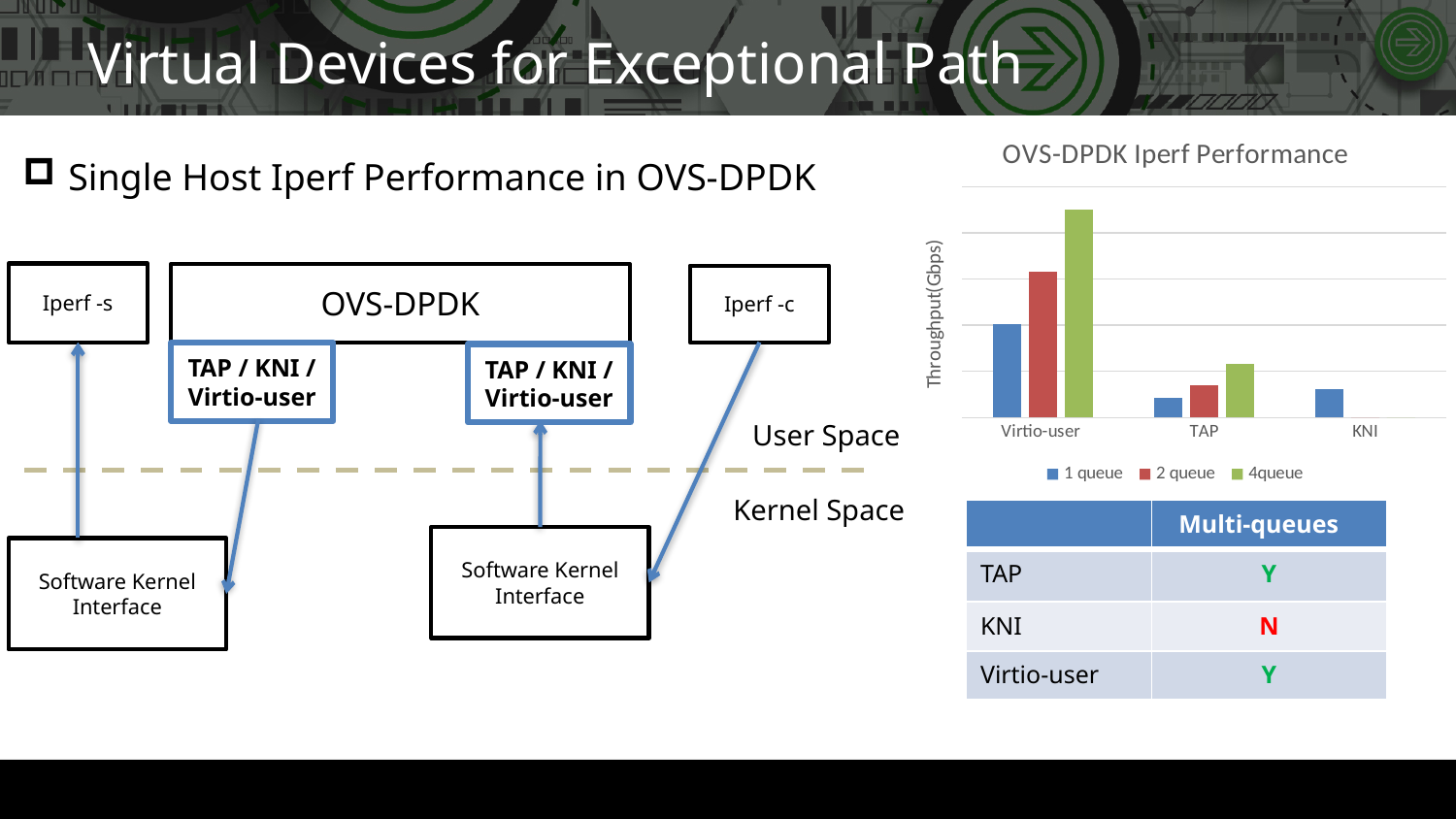
In the OVS-DPDK Iperf Performance chart, which series has the shortest bar for Virtio-user? 1 queue What is the y-axis label of the OVS-DPDK Iperf Performance chart? Throughput(Gbps) In the OVS-DPDK Iperf Performance chart, which category has the lowest 1 queue throughput? TAP How many series does the legend of the OVS-DPDK Iperf Performance chart list? 3 What type of chart is the OVS-DPDK Iperf Performance chart? bar chart In the OVS-DPDK Iperf Performance chart, is the 1 queue throughput higher for Virtio-user or for TAP? Virtio-user In the OVS-DPDK Iperf Performance chart, which category has only a 1 queue bar plotted? KNI What is the title of the chart on the slide? OVS-DPDK Iperf Performance How many categories are shown on the x axis of the OVS-DPDK Iperf Performance chart? 3 In the OVS-DPDK Iperf Performance chart, which category has the highest throughput overall? Virtio-user In the OVS-DPDK Iperf Performance chart, is the 4queue bar for TAP higher or lower than the 1 queue bar for KNI? higher In the OVS-DPDK Iperf Performance chart, which series has the tallest bar for Virtio-user? 4queue